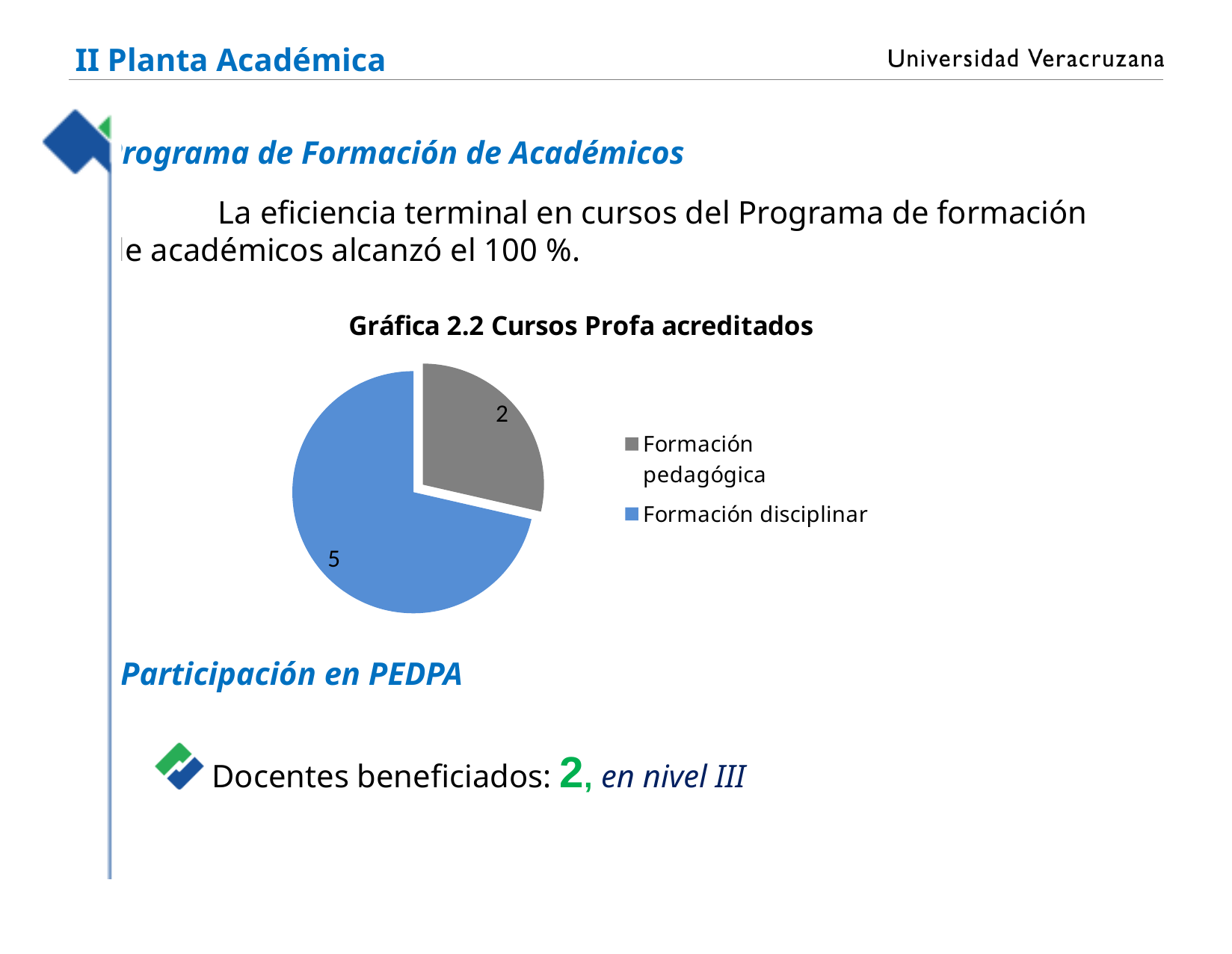
Which is larger, Formación pedagógica or Formación disciplinar? Formación disciplinar How many slices does the pie chart have? 2 Which colour represents Formación disciplinar in the pie chart? Blue Which category has the smallest slice? Formación pedagógica What is the title of the chart? Gráfica 2.2 Cursos Profa acreditados What type of chart is shown on the slide? Pie chart How many entries does the legend list? 2 What is the value for Formación disciplinar? 5 Which category has the largest slice? Formación disciplinar What is the value for Formación pedagógica? 2 What is the total of all slices in the pie chart? 7 What is the difference between the values for Formación disciplinar and Formación pedagógica? 3